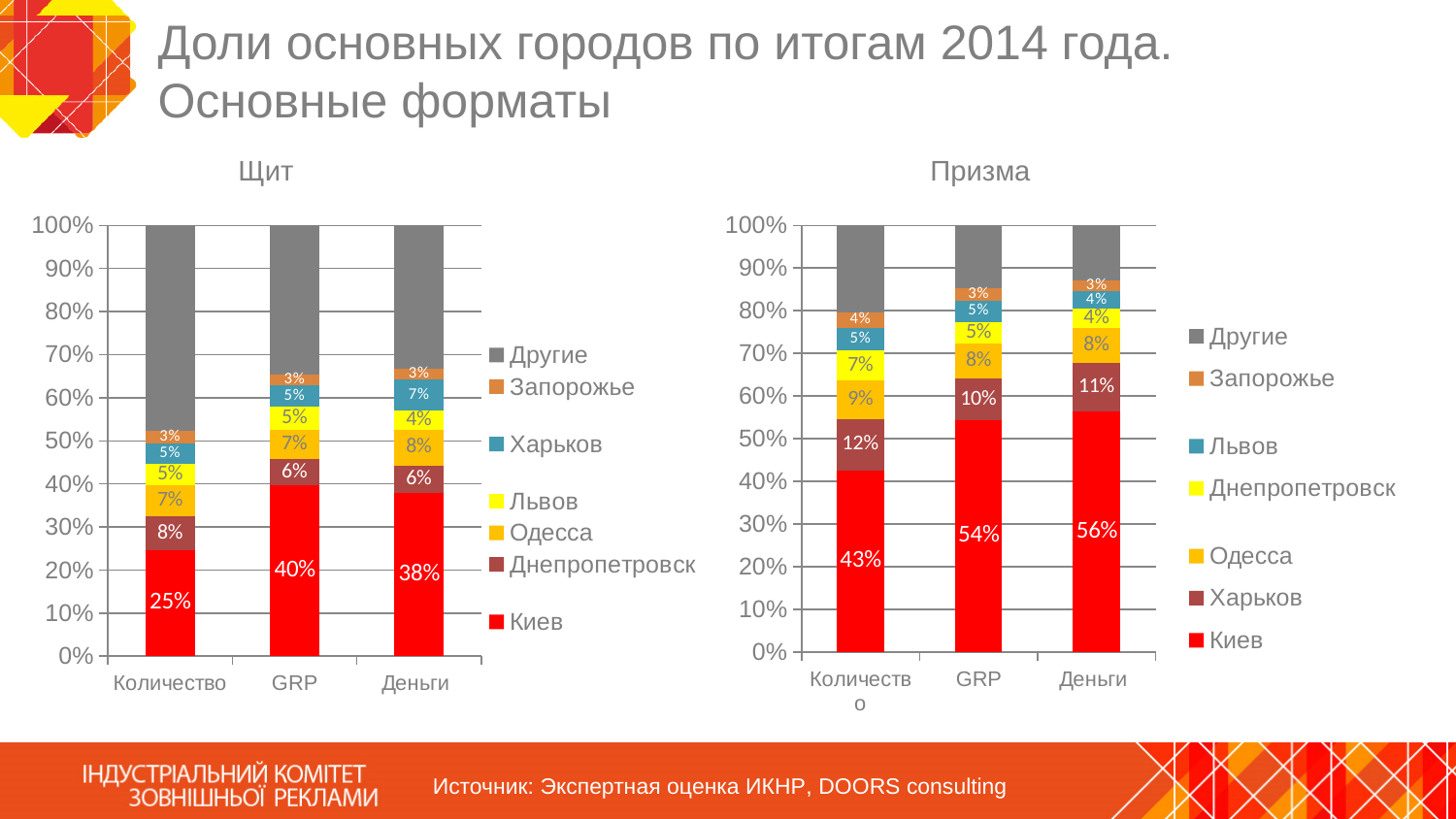
In the "Призма" chart, what is the value for Харьков in the Количество bar? 12% In the "Призма" chart, what is the value for Киев in the Деньги bar? 56% How many series does the legend of the "Призма" chart list? 7 What kind of chart is the "Щит" chart? Stacked bar chart In the "Щит" chart, what is the value for Киев in the Количество bar? 25% In the "Призма" chart, is the Киев value for Деньги greater or less than 50%? greater In the "Щит" chart, which category has the highest value for Киев? GRP How many categories are shown on the x axis of the "Щит" chart? 3 In the "Щит" chart, what is the difference between the Киев values for GRP and Деньги? 2% In the "Щит" chart, what is the value for Днепропетровск in the Количество bar? 8% In the "Призма" chart, which is larger: the Киев value for GRP or for Количество? GRP In the "Призма" chart, which category has the lowest value for Киев? Количество